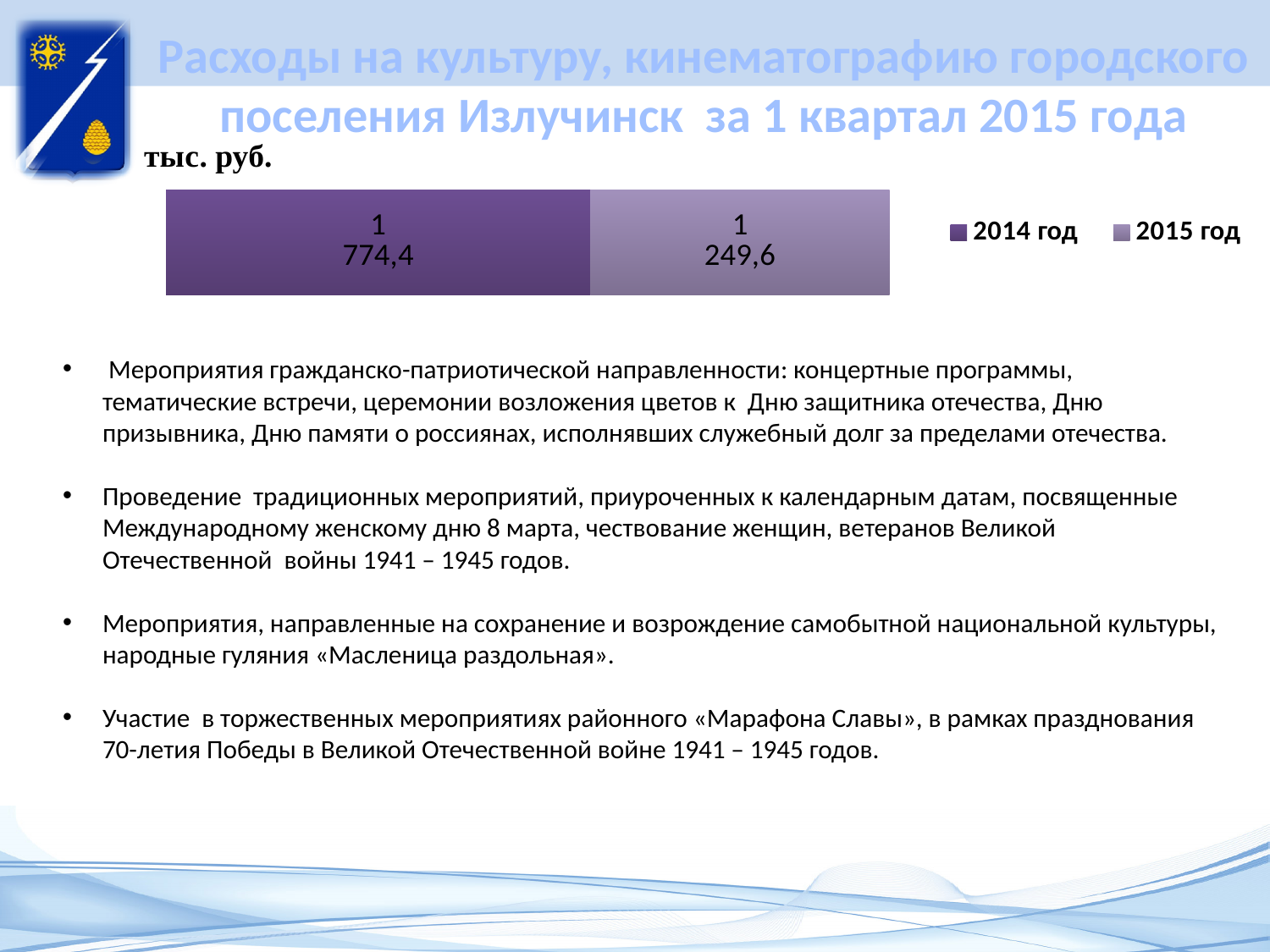
What is the value for 2015 год on the chart? 1 249,6 How many series does the legend list? 2 Which series has the lowest value on the chart? 2015 год Which series has the highest value on the chart? 2014 год What is the difference between the 2014 год and 2015 год values? 524,8 Which series has the higher value, 2014 год or 2015 год? 2014 год Which series is shown in the darker purple colour? 2014 год What is the value for 2014 год on the chart? 1 774,4 In what units are the chart values given? тыс. руб. What kind of chart is shown on the slide? Stacked bar chart What is the total of the stacked bar (2014 год plus 2015 год)? 3 024,0